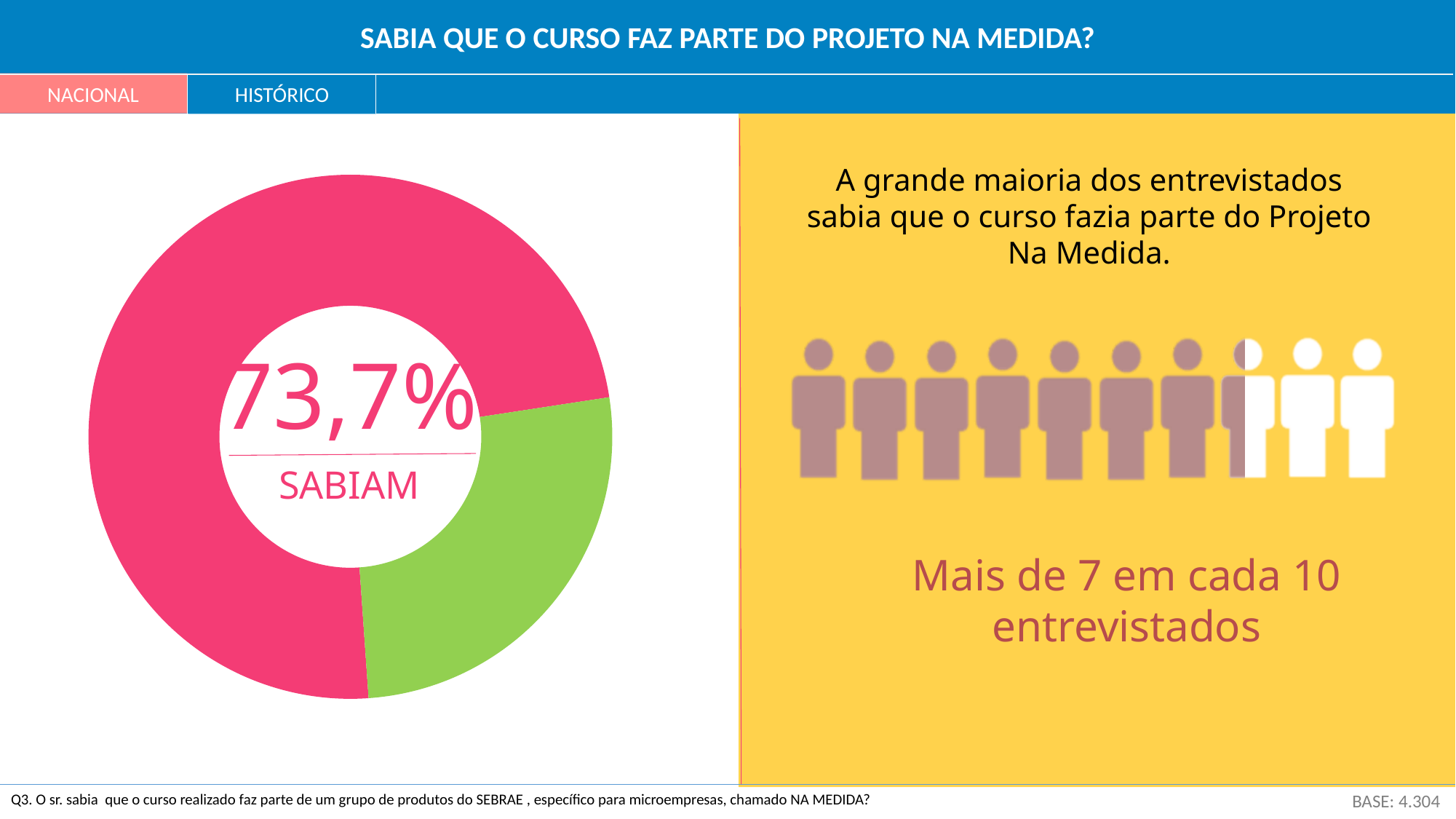
What kind of chart is shown on the left of the slide? Pie chart (donut) What is the base (number of respondents) shown at the bottom right of the slide? 4.304 How many slices does the donut chart have? 2 What percentage of respondents 'SABIAM' (knew) according to the chart? 73,7% How many person icons are shown in the pictogram on the right side of the slide? 10 What colour is the slice labelled 'SABIAM' in the donut chart? Pink Which slice of the donut chart is the largest? SABIAM (73,7%) Which slice of the donut chart is larger, the pink one or the green one? The pink one What is the title of the slide containing the chart? SABIA QUE O CURSO FAZ PARTE DO PROJETO NA MEDIDA?